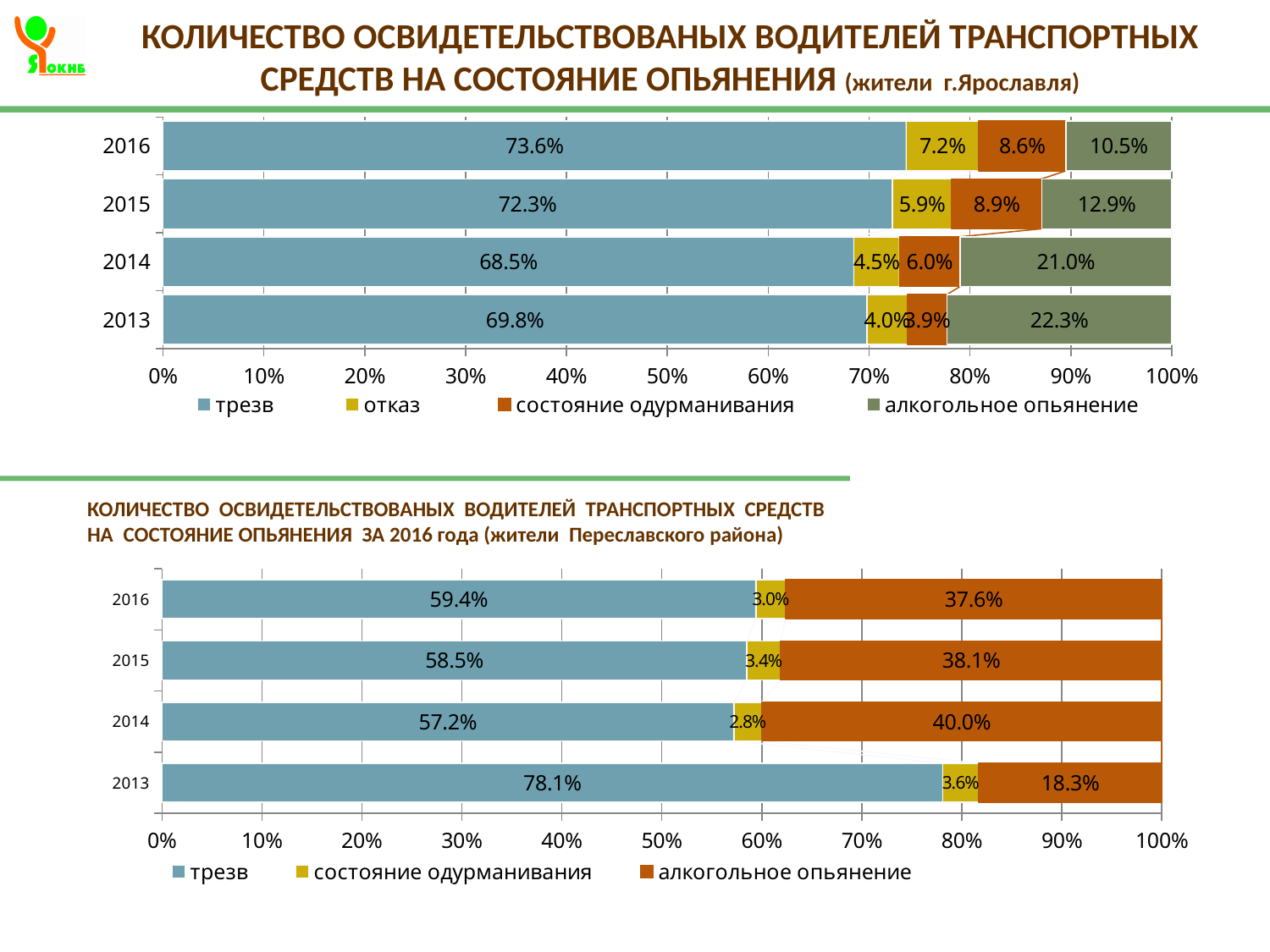
In the top chart (жители г.Ярославля), what is the value for отказ in 2015? 5.9% In the top chart (жители г.Ярославля), what is the value for алкогольное опьянение in 2014? 21.0% In the top chart (жители г.Ярославля), how many series does the legend list? 4 In the top chart (жители г.Ярославля), which year has the highest value for алкогольное опьянение? 2013 In the bottom chart (жители Переславского района), which year has the lowest value for алкогольное опьянение? 2013 In the bottom chart (жители Переславского района), what is the value for трезв in 2013? 78.1% In the bottom chart (жители Переславского района), is the трезв value for 2016 or 2015 larger? 2016 In the bottom chart (жители Переславского района), what is the value for алкогольное опьянение in 2014? 40.0% In the top chart (жители г.Ярославля), what is the difference between the трезв values for 2016 and 2015? 1.3% What type of chart is the bottom chart (жители Переславского района)? Stacked bar chart In the bottom chart (жители Переславского района), how many years are shown? 4 In the top chart (жители г.Ярославля), what is the value for трезв in 2016? 73.6%